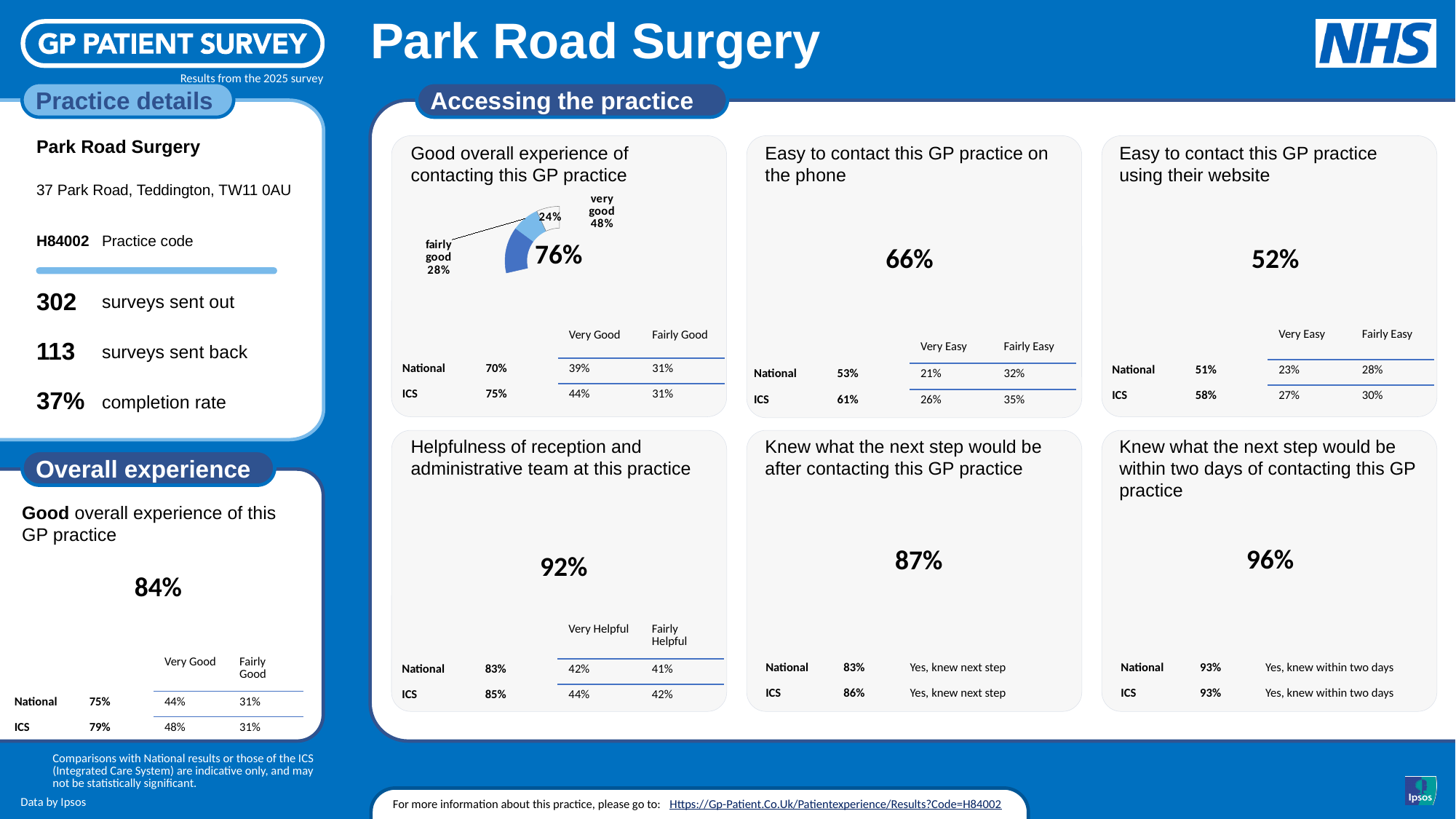
In the 'Good overall experience of contacting this GP practice' pie chart, what share is labelled 'fairly good'? 28% In the 'Good overall experience of contacting this GP practice' pie chart, which is larger, the 'very good' slice or the 'fairly good' slice? very good How many slices does the 'Good overall experience of contacting this GP practice' pie chart have? 3 In the 'Good overall experience of contacting this GP practice' pie chart, what is the combined share of 'very good' and 'fairly good'? 76% In the 'Good overall experience of contacting this GP practice' pie chart, what is the difference between the 'very good' and 'fairly good' shares? 20% In the table below the 'Good overall experience of contacting this GP practice' pie chart, what is the National 'Very Good' value? 39% In the 'Good overall experience of contacting this GP practice' pie chart, is the 'fairly good' share greater or less than 30%? less What kind of chart is shown in the 'Good overall experience of contacting this GP practice' panel? pie chart In the 'Good overall experience of contacting this GP practice' pie chart, what share is labelled 'very good'? 48% In the 'Good overall experience of contacting this GP practice' pie chart, what share is shown for the slice that is not labelled 'very good' or 'fairly good'? 24% In the 'Good overall experience of contacting this GP practice' pie chart, which labelled slice is the largest? very good What percentage is printed in large text beside the 'Good overall experience of contacting this GP practice' pie chart? 76%